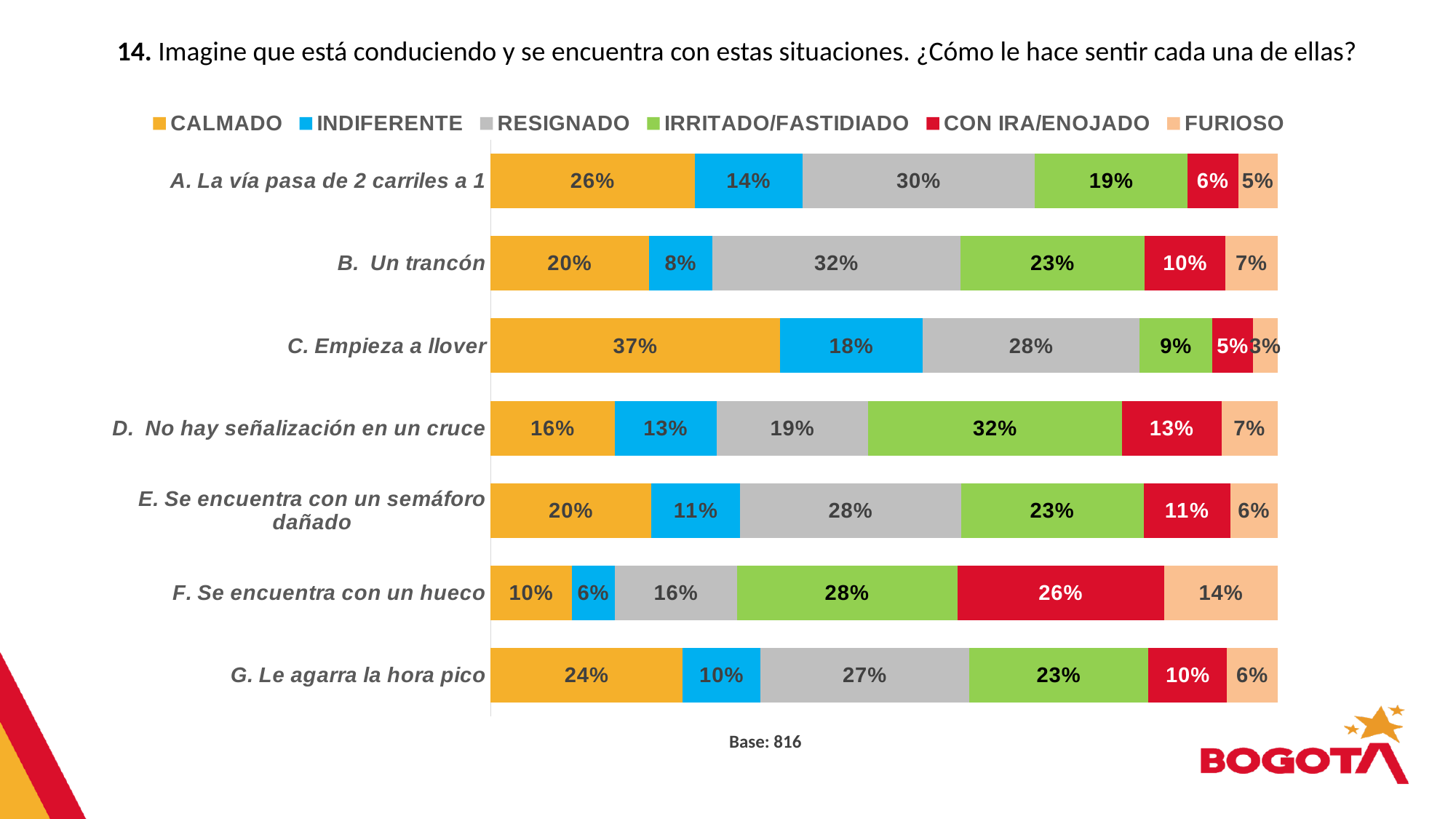
How many series does the legend list? 6 What is the FURIOSO value for 'F. Se encuentra con un hueco'? 14% What is the difference between the IRRITADO/FASTIDIADO values for 'D. No hay señalización en un cruce' and 'C. Empieza a llover'? 23% What kind of chart is shown on the slide? Stacked bar chart What is the total of the stacked bar for 'A. La vía pasa de 2 carriles a 1'? 100% Which situation has the highest CALMADO percentage? C. Empieza a llover Which situation has the highest CON IRA/ENOJADO percentage? F. Se encuentra con un hueco How many situations (categories) are shown in the chart? 7 What is the RESIGNADO value for 'B. Un trancón'? 32% Which situation has the lowest CALMADO percentage? F. Se encuentra con un hueco Which is larger: the INDIFERENTE value for 'A. La vía pasa de 2 carriles a 1' or for 'G. Le agarra la hora pico'? A. La vía pasa de 2 carriles a 1 What percentage of respondents feel CALMADO when 'C. Empieza a llover'? 37%